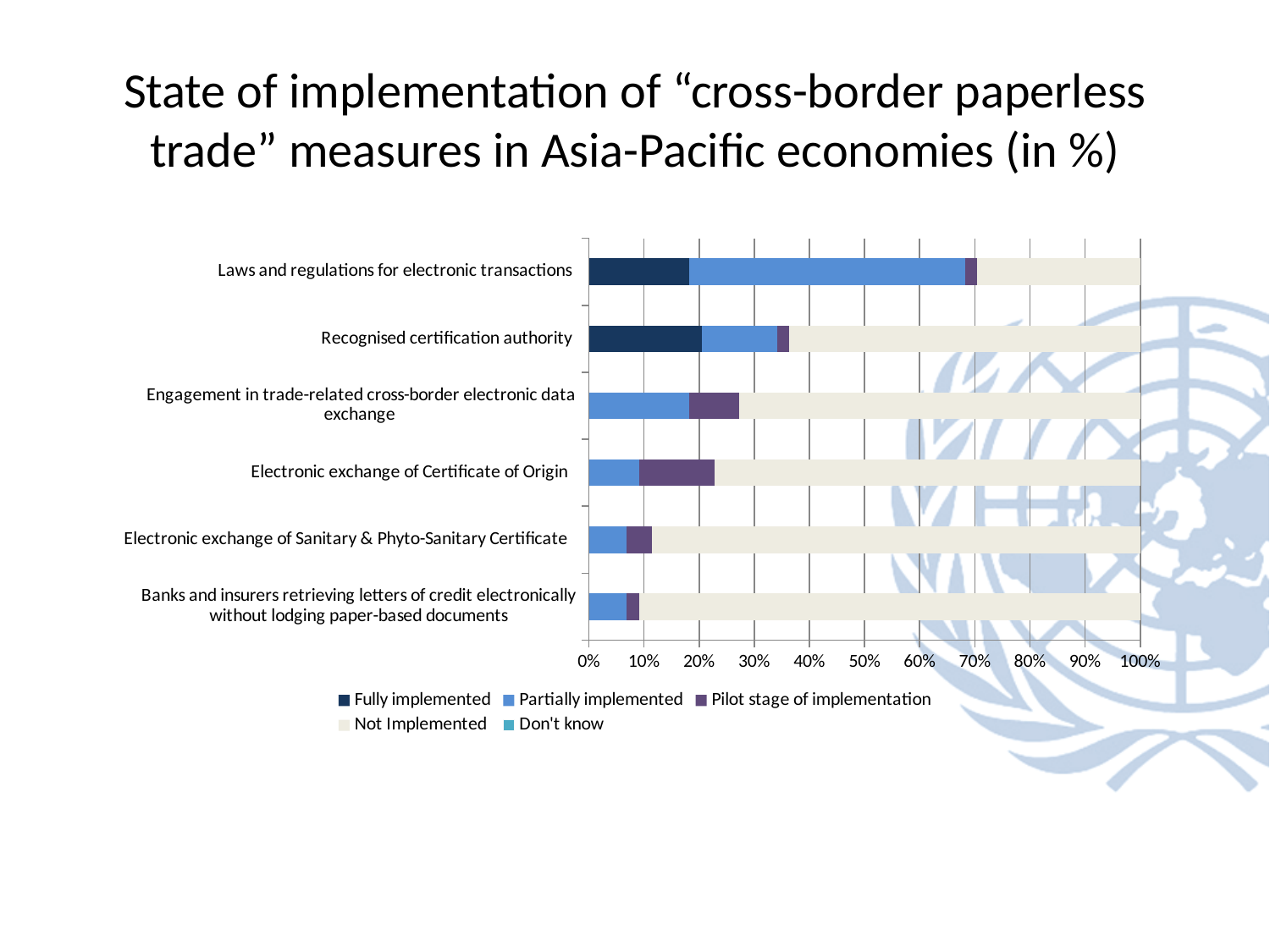
How many series does the legend list? 5 Is the 'Not Implemented' value for 'Banks and insurers retrieving letters of credit electronically without lodging paper-based documents' greater or less than 80%? greater Is the 'Not Implemented' share larger for 'Laws and regulations for electronic transactions' or for 'Banks and insurers retrieving letters of credit electronically without lodging paper-based documents'? Banks and insurers retrieving letters of credit electronically without lodging paper-based documents Which measure has the largest 'Partially implemented' segment? Laws and regulations for electronic transactions How many measures (categories) are plotted on the chart? 6 Which measure has the largest 'Pilot stage of implementation' segment? Electronic exchange of Certificate of Origin Is the 'Partially implemented' value for 'Laws and regulations for electronic transactions' greater or less than 40%? greater Is the 'Fully implemented' value for 'Laws and regulations for electronic transactions' greater or less than 10%? greater Which series is listed last in the legend? Don't know What kind of chart is shown on the slide? Stacked bar chart What is the title of the slide containing the chart? State of implementation of "cross-border paperless trade" measures in Asia-Pacific economies (in %)